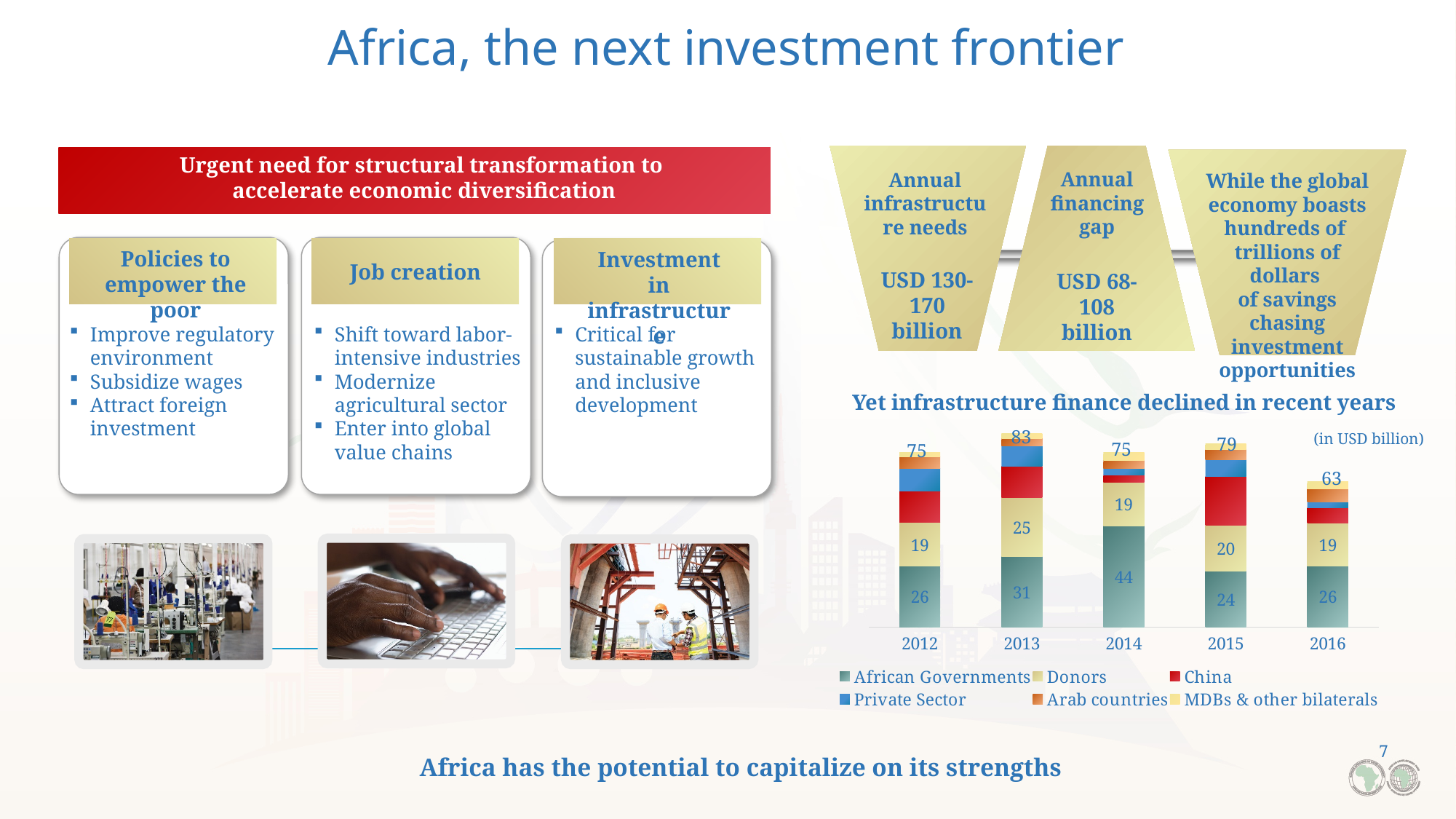
How many years are shown on the x axis of the chart? 5 What is the value for Donors in 2013? 25 Which year has the highest total infrastructure finance? 2013 What is the total infrastructure finance shown for 2013? 83 What is the value for African Governments in 2014? 44 What is the difference between the African Governments value in 2013 and in 2012? 5 What is the difference between the total for 2013 and the total for 2016? 20 In what unit are the chart values expressed? USD billion What type of chart is shown under the heading 'Yet infrastructure finance declined in recent years'? Stacked bar chart Which is larger, the African Governments value in 2014 or in 2015? 2014 Which year has the lowest total infrastructure finance? 2016 How many series does the chart legend list? 6